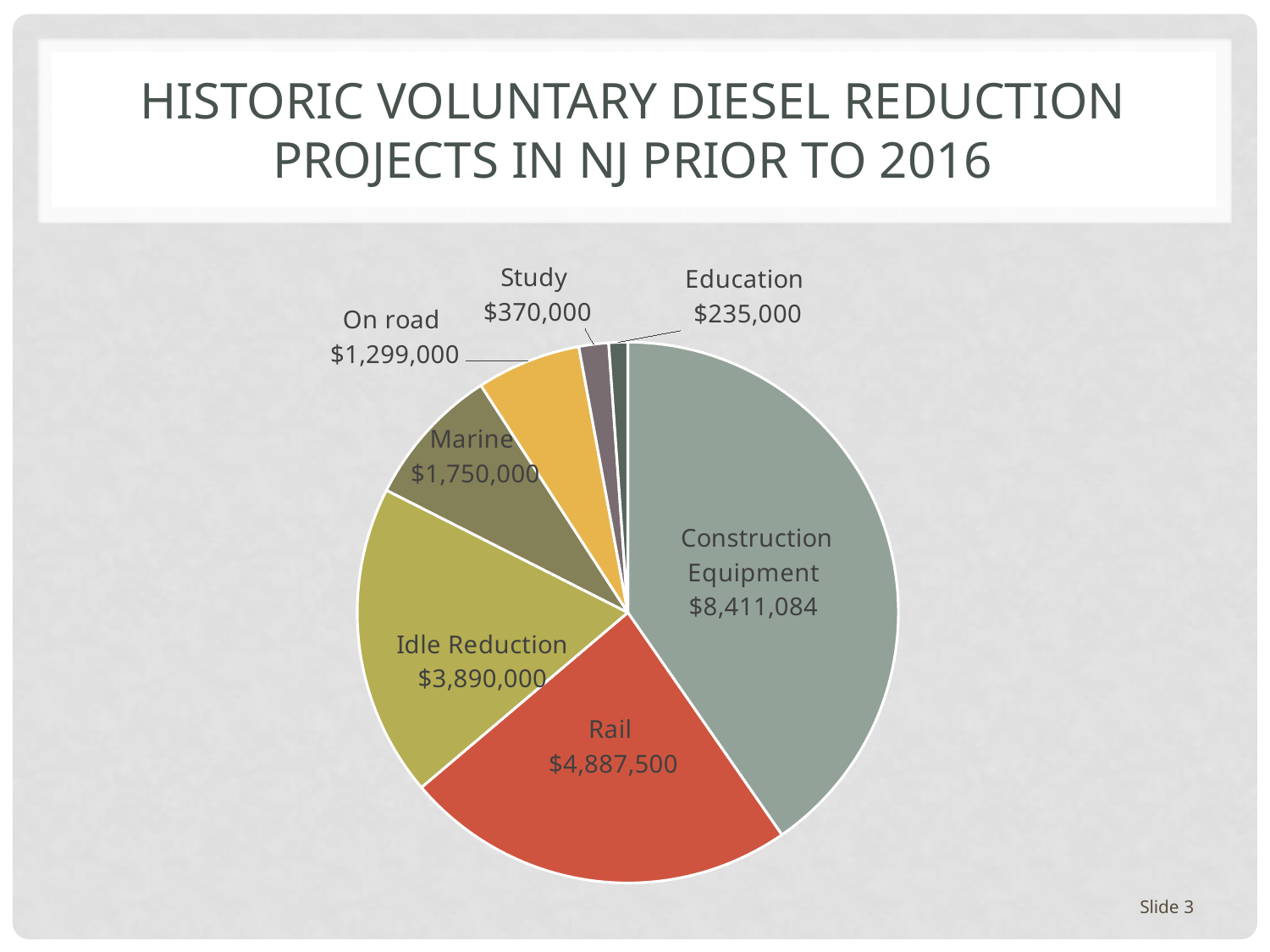
Which category has the smallest slice of the pie? Education How many categories (slices) does the pie chart have? 7 What is the title of the slide containing the pie chart? Historic Voluntary Diesel Reduction Projects in NJ Prior to 2016 What is the value for Construction Equipment? $8,411,084 What is the difference between the Study value and the Education value? $135,000 Which is larger, Marine or On road? Marine What is the difference between the Construction Equipment value and the Rail value? $3,523,584 What kind of chart is shown on the slide? Pie chart What is the value for Study? $370,000 What share of the total does Construction Equipment represent, to one decimal place? 40.4% Which category has the largest slice of the pie? Construction Equipment What is the value for Idle Reduction? $3,890,000